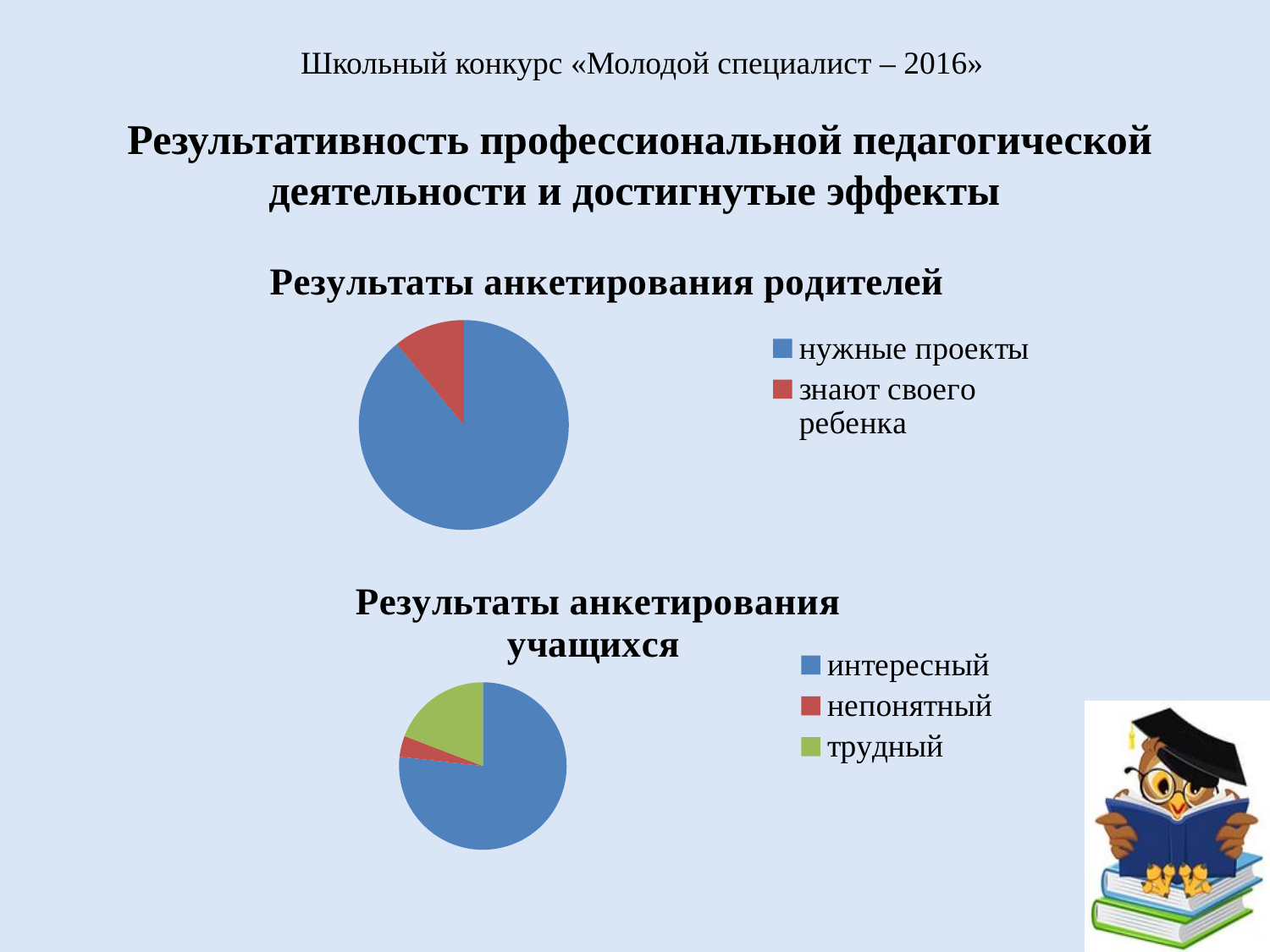
In the chart "Результаты анкетирования родителей", which category has the smallest slice? знают своего ребенка In the chart "Результаты анкетирования родителей", how many slices does the pie have? 2 In the chart "Результаты анкетирования учащихся", how many slices does the pie have? 3 In the chart "Результаты анкетирования учащихся", what colour is the slice for "трудный"? green How many entries does the legend of the chart "Результаты анкетирования родителей" list? 2 How many entries does the legend of the chart "Результаты анкетирования учащихся" list? 3 In the chart "Результаты анкетирования родителей", which category has the largest slice? нужные проекты In the chart "Результаты анкетирования учащихся", which category has the smallest slice? непонятный In the chart "Результаты анкетирования учащихся", which category has the largest slice? интересный In the chart "Результаты анкетирования учащихся", which slice is larger: "трудный" or "непонятный"? трудный What kind of chart is the chart titled "Результаты анкетирования учащихся"? pie chart What kind of chart is the chart titled "Результаты анкетирования родителей"? pie chart